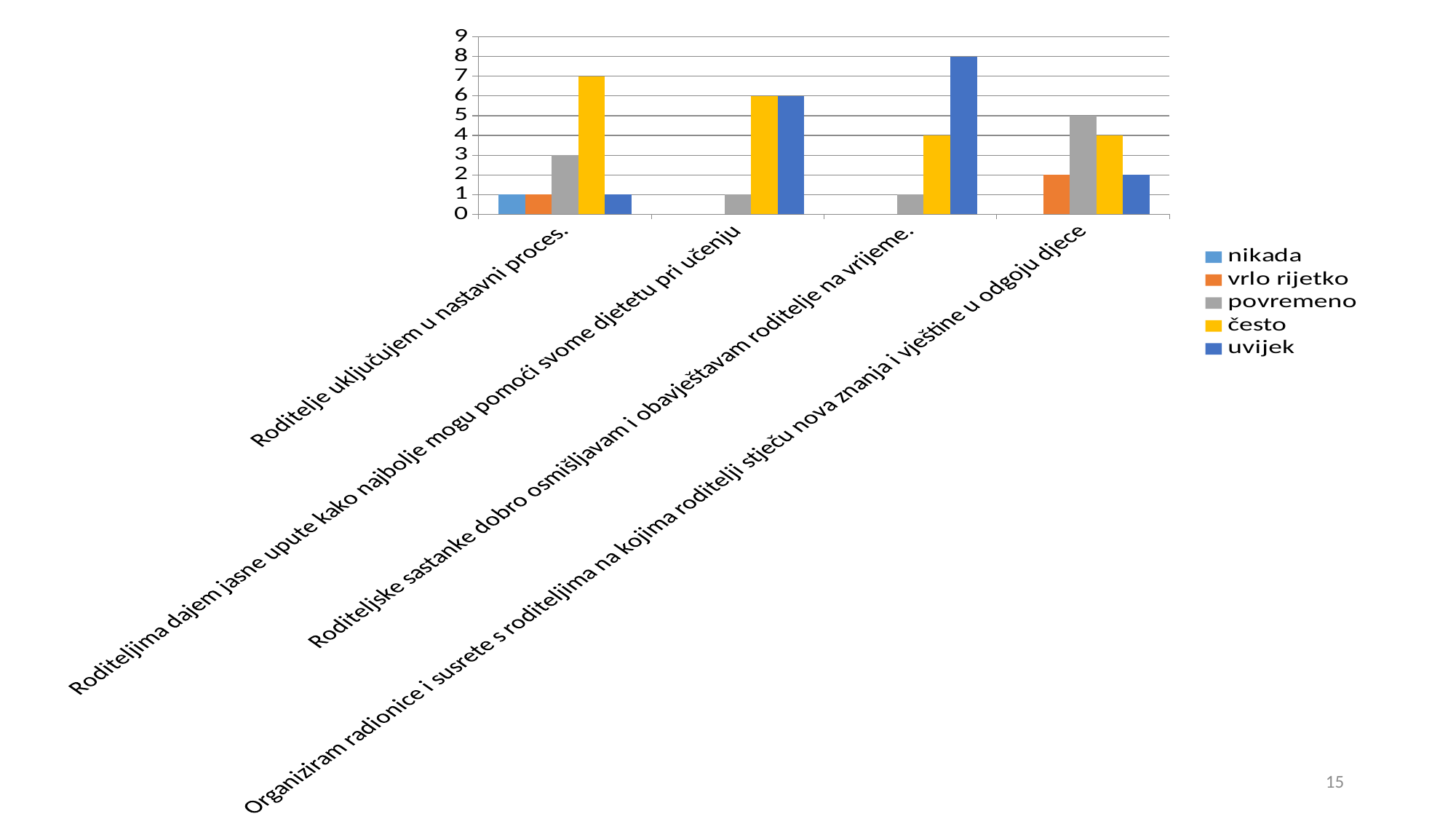
What is the value of 'povremeno' for 'Organiziram radionice i susrete s roditeljima na kojima roditelji stječu nova znanja i vještine u odgoju djece'? 5 What is the difference between 'uvijek' and 'često' for 'Roditeljske sastanke dobro osmišljavam i obavještavam roditelje na vrijeme.'? 4 What is the value of 'često' for 'Roditelje uključujem u nastavni proces.'? 7 Which category has the highest 'uvijek' value? Roditeljske sastanke dobro osmišljavam i obavještavam roditelje na vrijeme. Which is larger for 'Organiziram radionice i susrete s roditeljima na kojima roditelji stječu nova znanja i vještine u odgoju djece': 'povremeno' or 'uvijek'? povremeno Which series has the highest value for 'Roditelje uključujem u nastavni proces.'? često What is the value of 'vrlo rijetko' for 'Organiziram radionice i susrete s roditeljima na kojima roditelji stječu nova znanja i vještine u odgoju djece'? 2 How many categories are shown on the x axis? 4 Which legend entry is shown in yellow? često What kind of chart is shown on the slide? bar chart What is the value of 'uvijek' for 'Roditeljske sastanke dobro osmišljavam i obavještavam roditelje na vrijeme.'? 8 How many series does the legend list? 5